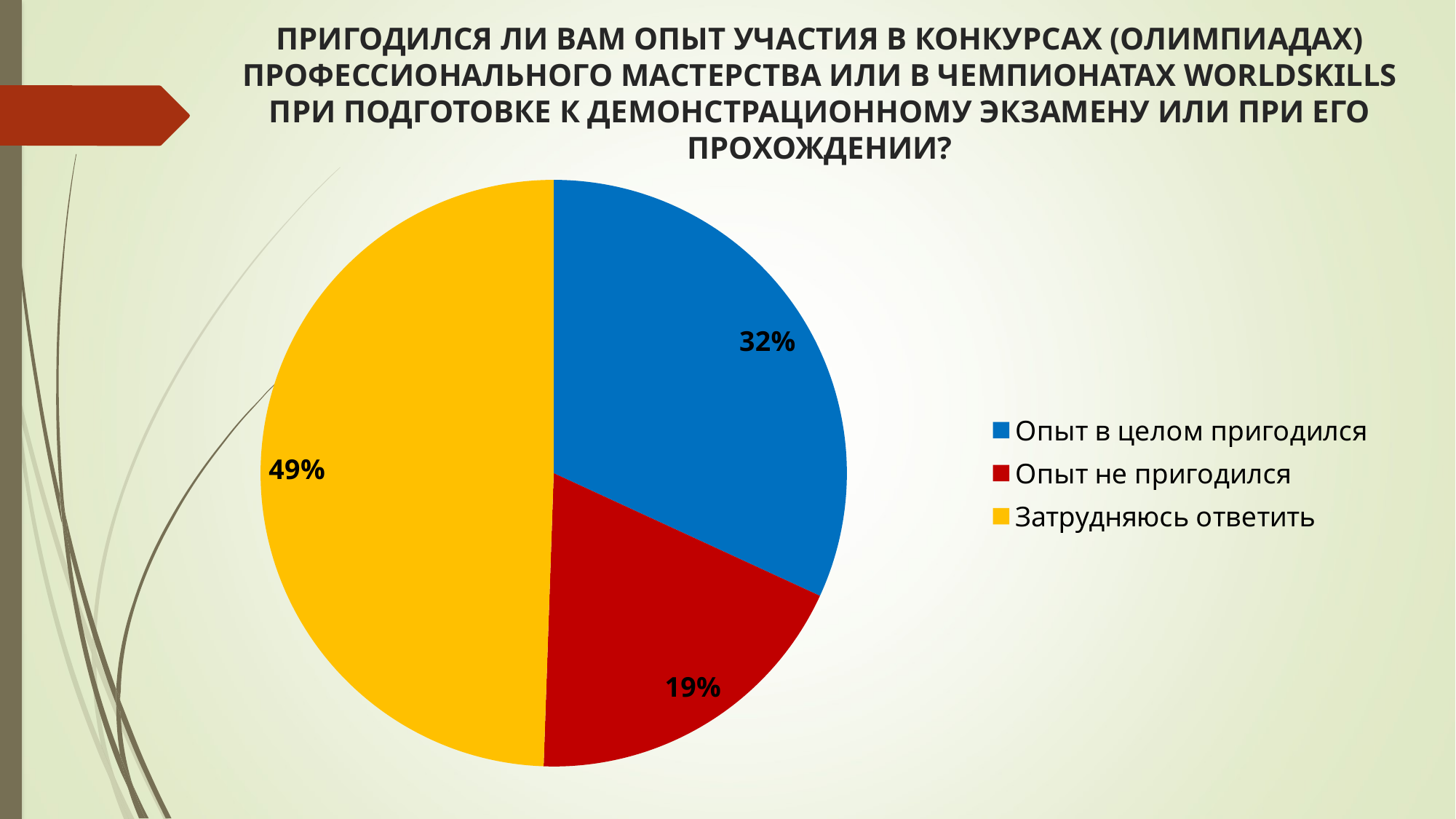
Which category has the smallest slice of the pie? Опыт не пригодился What is the difference in percentage points between "Опыт в целом пригодился" and "Опыт не пригодился"? 13 Which is larger: the slice for "Опыт в целом пригодился" or the slice for "Опыт не пригодился"? Опыт в целом пригодился What kind of chart is shown on the slide? Pie chart Which category has the largest slice of the pie? Затрудняюсь ответить What share of the pie does "Опыт в целом пригодился" have? 32% What is the difference in percentage points between "Затрудняюсь ответить" and "Опыт в целом пригодился"? 17 How many entries does the legend list? 3 What colour is the slice for "Затрудняюсь ответить"? Yellow What share of the pie does "Затрудняюсь ответить" have? 49% How many slices does the pie chart have? 3 What share of the pie does "Опыт не пригодился" have? 19%